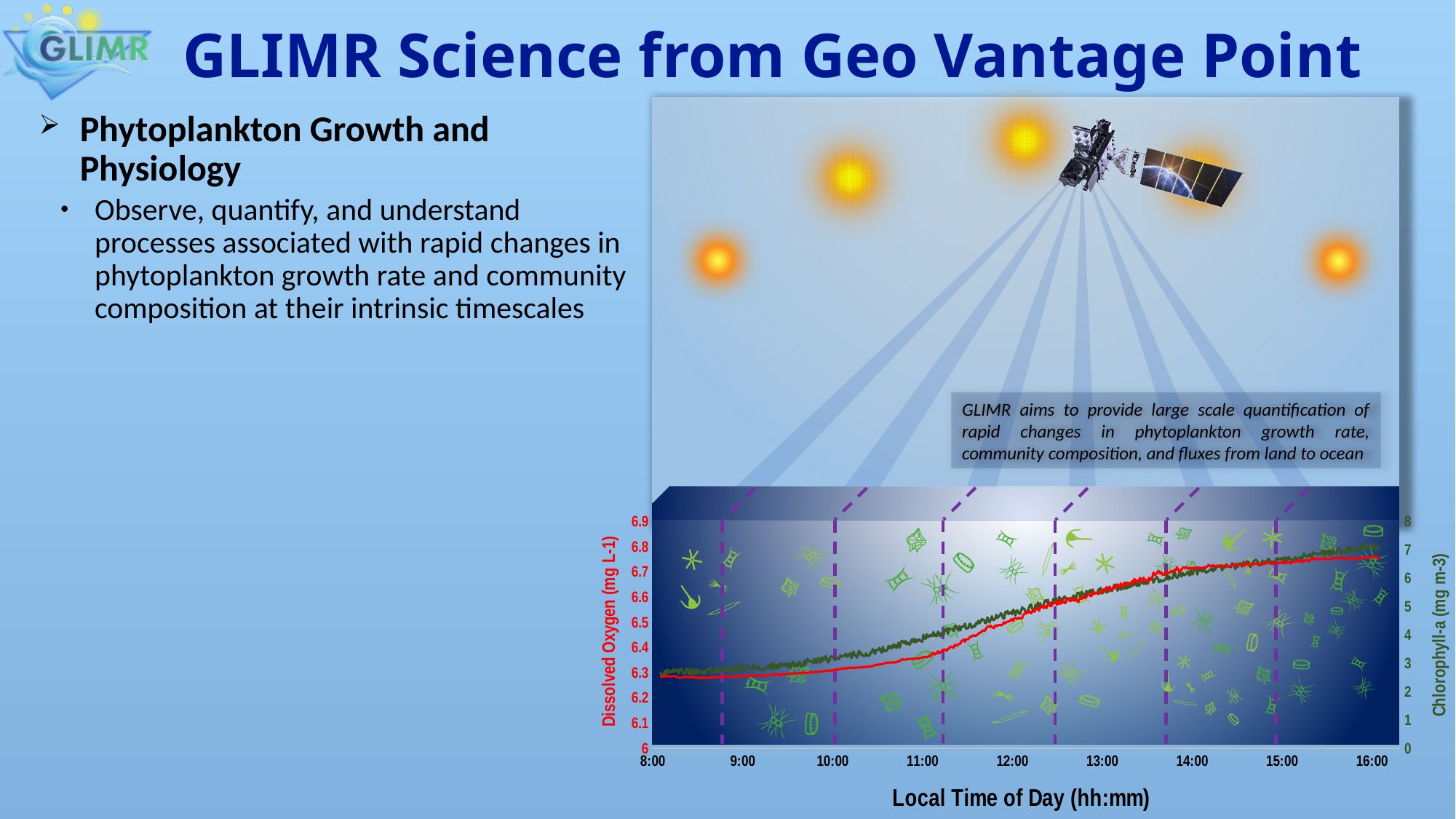
What is the label of the x axis of the chart? Local Time of Day (hh:mm) Is the Dissolved Oxygen value at 11:00 greater or less than 6.5? less Does the green Chlorophyll-a line rise or fall over the course of the day? rise How many time labels are shown on the x axis of the chart? 9 How many lines are plotted on the chart? 2 Does the red Dissolved Oxygen line rise or fall from 8:00 to 16:00? rise Is the Chlorophyll-a value at 12:00 greater or less than 4? greater Is the Chlorophyll-a value at 15:00 greater or less than 6? greater What kind of chart is shown at the bottom right of the slide? line chart What is the label of the left y axis of the chart? Dissolved Oxygen (mg L-1)